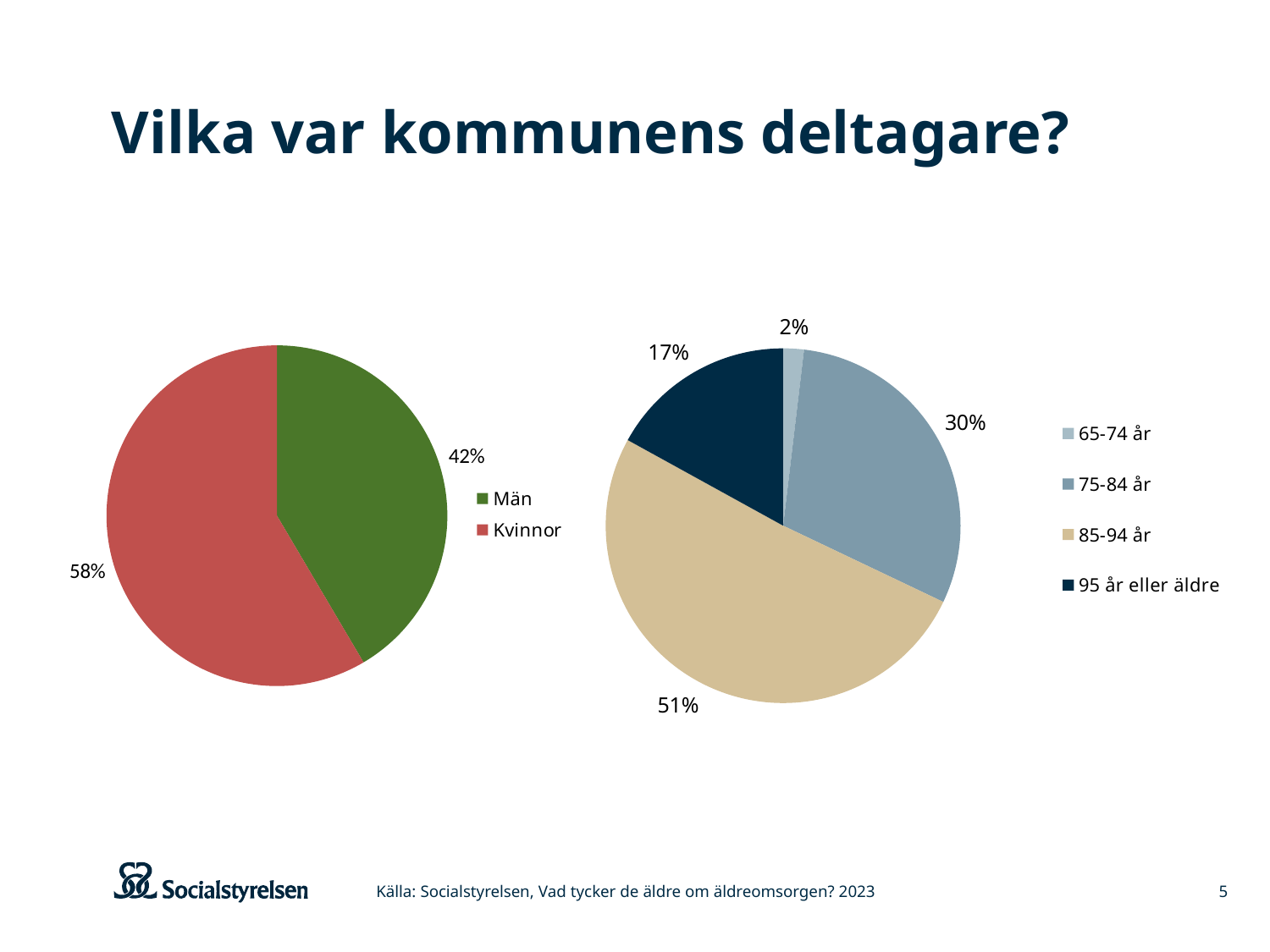
In the left pie chart, what is the difference in percentage points between Kvinnor and Män? 16 percentage points In the left pie chart, what share of participants are Män? 42% In the right pie chart, which age group has the smallest share? 65-74 år In the left pie chart, what share of participants are Kvinnor? 58% In the right pie chart, what share of participants are 95 år eller äldre? 17% How many categories does the legend of the right pie chart list? 4 In the right pie chart, what is the difference in percentage points between the 75-84 år and 95 år eller äldre groups? 13 percentage points In the right pie chart, which age group has the largest share? 85-94 år In the left pie chart, which group has the larger share, Män or Kvinnor? Kvinnor What type of chart is the left chart on the slide? Pie chart